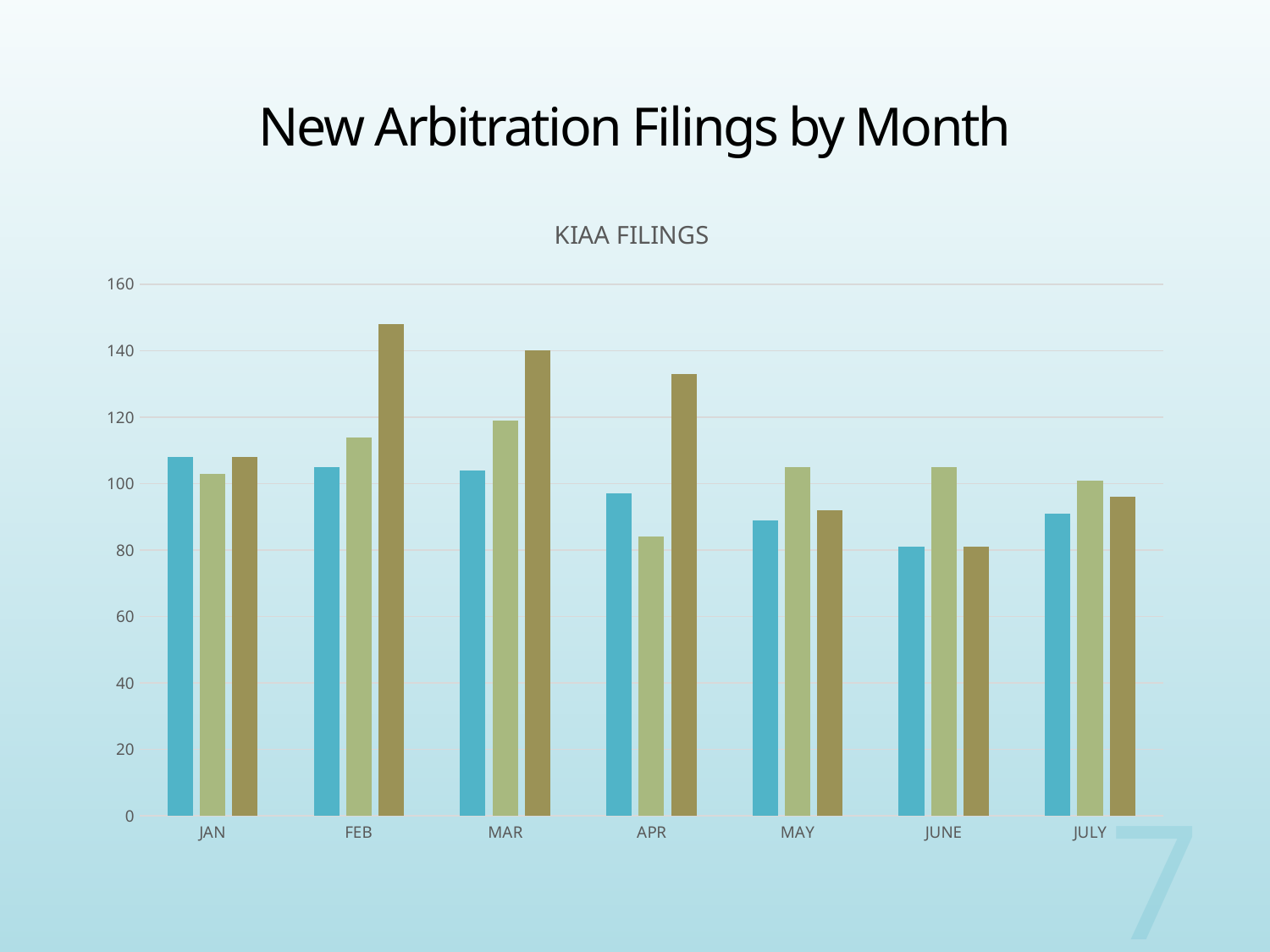
Is the value of the blue bar for JUNE greater or less than 100? less In MAR, which is larger: the brown bar or the blue bar? the brown bar In APR, which is larger: the blue bar or the light green bar? the blue bar Is the value of the brown bar for APR greater or less than 120? greater Do the blue bars rise or fall from JAN to JUNE? fall What kind of chart is shown on the slide? bar chart Is the value of the light green bar for MAR greater or less than 100? greater How many bars are plotted for each month? 3 Which month has the tallest bar in the chart? FEB How many months are shown on the x axis of the chart? 7 What is the title printed above the chart? KIAA FILINGS